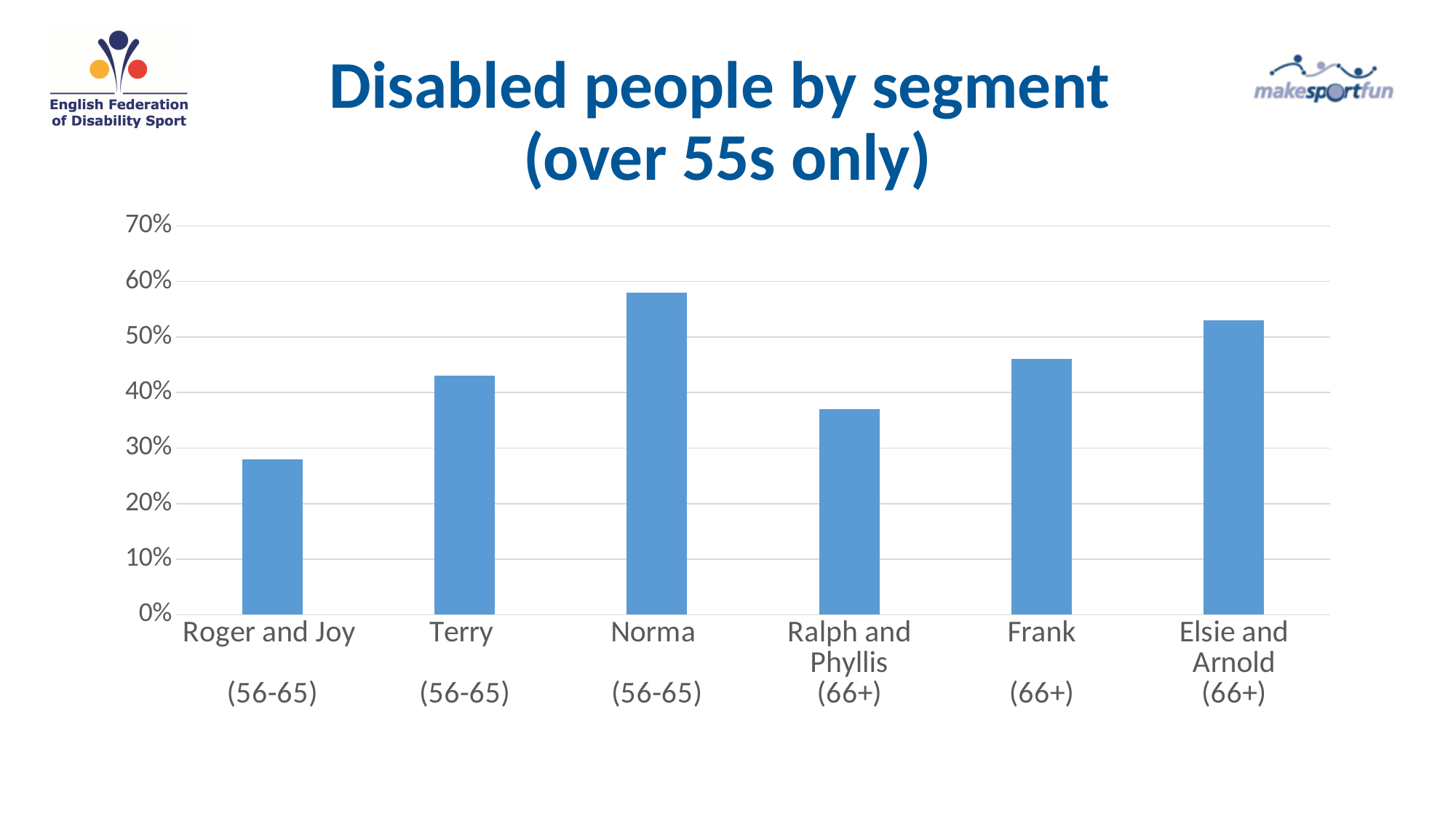
Which is larger, the value for Frank or the value for Ralph and Phyllis? Frank Is the value for Terry greater or less than 40%? greater Which segment has the highest value? Norma Is the value for Ralph and Phyllis greater or less than 40%? less Is the value for Roger and Joy greater or less than 30%? less What kind of chart is shown on the slide? bar chart How many segments (categories) are plotted on the chart? 6 What is the title of the chart? Disabled people by segment (over 55s only) Which is larger, the value for Terry or the value for Elsie and Arnold? Elsie and Arnold Which segment has the lowest value? Roger and Joy